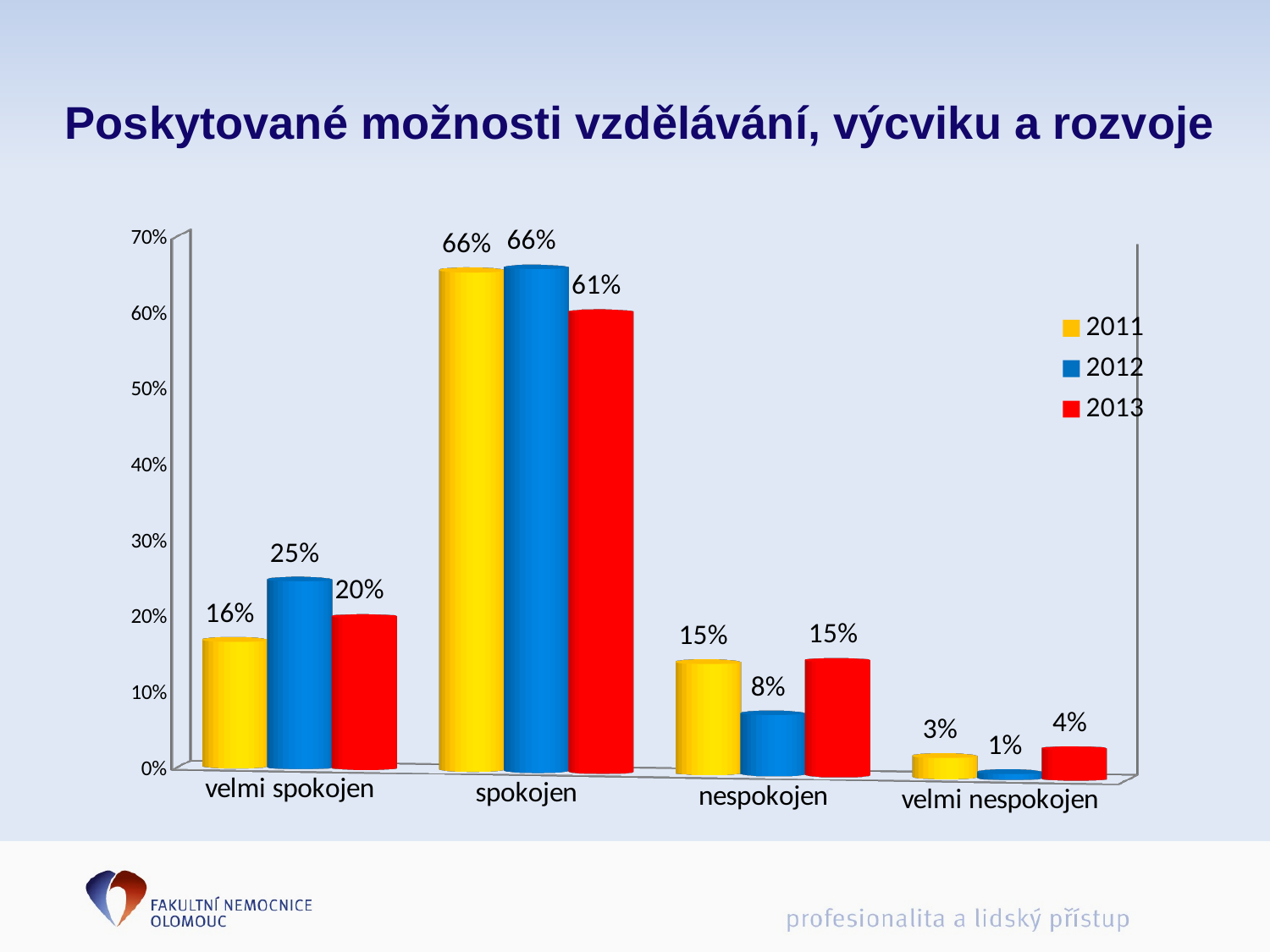
What is the difference between the 2012 and 2011 values in the 'velmi spokojen' category? 9% What is the value for 2013 in the 'spokojen' category? 61% How many categories are shown on the x axis? 4 What is the value for 2012 in the 'velmi nespokojen' category? 1% Which category has the lowest value for 2011? velmi nespokojen Which colour represents the 2013 series in the legend? red Which is larger in the 'nespokojen' category: the 2011 value or the 2012 value? 2011 What is the value for 2012 in the 'velmi spokojen' category? 25% What is the value for 2011 in the 'nespokojen' category? 15% What kind of chart is shown on the slide? bar chart How many series does the legend list? 3 Which category has the highest value for 2013? spokojen